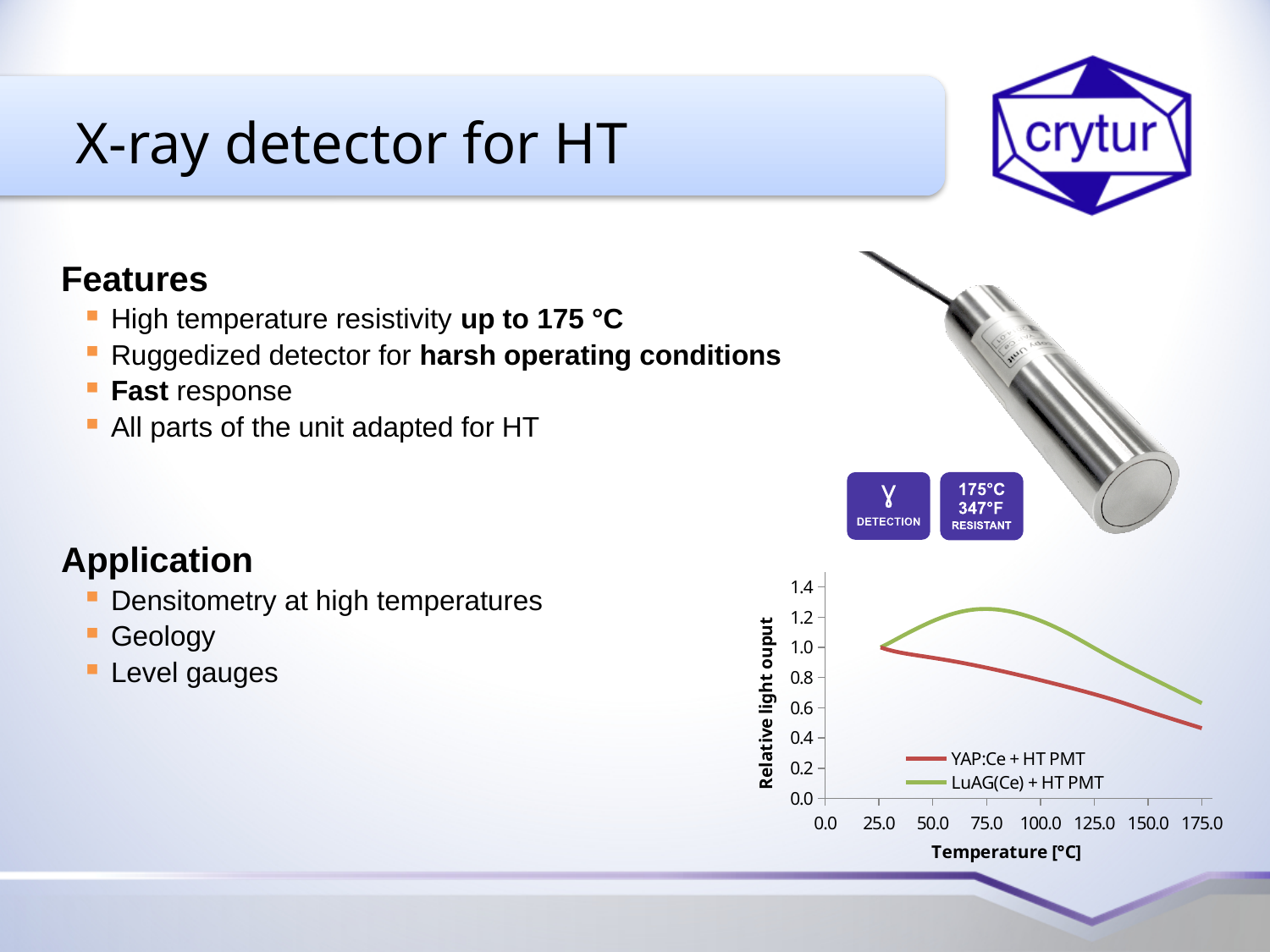
Is the relative light output of YAP:Ce + HT PMT at 175.0 °C greater or less than 0.6? less What is the highest value shown on the chart's y axis? 1.4 Which series has the higher relative light output at 75.0 °C? LuAG(Ce) + HT PMT What kind of chart is shown on the slide? line chart What is the label of the chart's y axis? Relative light output What are the two series named in the chart legend? YAP:Ce + HT PMT and LuAG(Ce) + HT PMT How many series does the chart legend list? 2 Is the relative light output of YAP:Ce + HT PMT at 100.0 °C greater or less than 1.0? less Is the relative light output of LuAG(Ce) + HT PMT at 75.0 °C greater or less than 1.0? greater Does the YAP:Ce + HT PMT line rise or fall as temperature increases? fall Which series has the higher relative light output at 175.0 °C? LuAG(Ce) + HT PMT